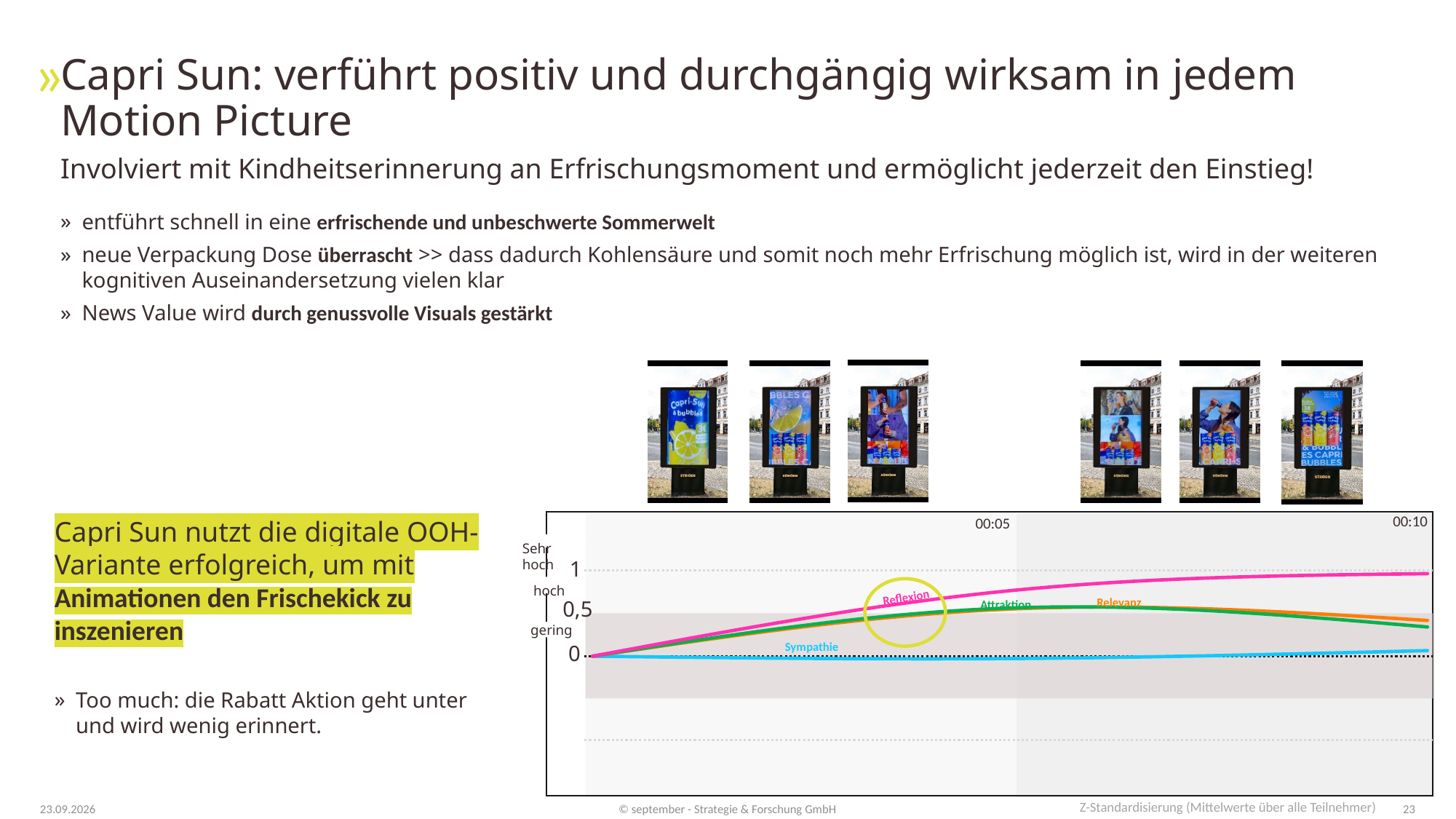
How many series are plotted in the chart? 4 Which series has the highest value at 00:10? Reflexion Is the value for Attraktion at 00:10 greater or less than 0,5? less Which time markers are shown along the top of the chart? 00:05 and 00:10 Does the Reflexion line rise or fall from the start to 00:10? rise Which series has the lowest value at 00:10? Sympathie At 00:10, which is larger: Reflexion or Sympathie? Reflexion Is the value for Reflexion at 00:10 greater or less than 0,5? greater Is the value for Reflexion at 00:05 greater or less than 0,5? greater What colour is the Reflexion line? pink What kind of chart is shown on the slide? line chart